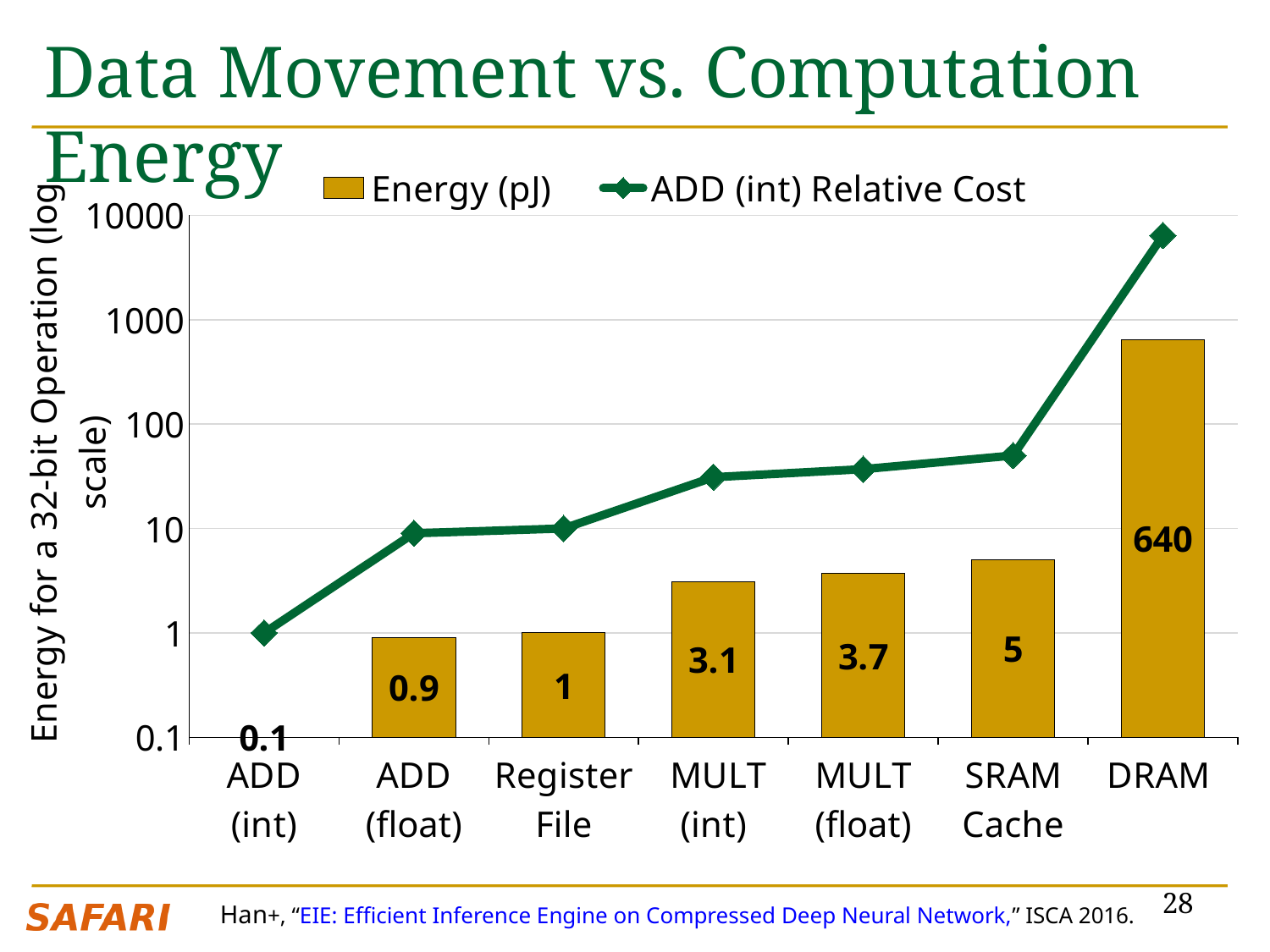
Which category has the lowest Energy (pJ) value? ADD (int) What is the Energy (pJ) value for MULT (float)? 3.7 How many categories are shown on the x axis? 7 What is the Energy (pJ) value for ADD (int)? 0.1 What is the difference in Energy (pJ) between DRAM and SRAM Cache? 635 Which category has the highest Energy (pJ) value? DRAM What is the Energy (pJ) value for DRAM? 640 How many series does the legend list? 2 Is the ADD (int) Relative Cost value for DRAM greater or less than 1000? greater Which has a larger Energy (pJ) value, MULT (int) or ADD (float)? MULT (int) What is the Energy (pJ) value for SRAM Cache? 5 Does the ADD (int) Relative Cost line rise or fall from ADD (int) to DRAM? rise